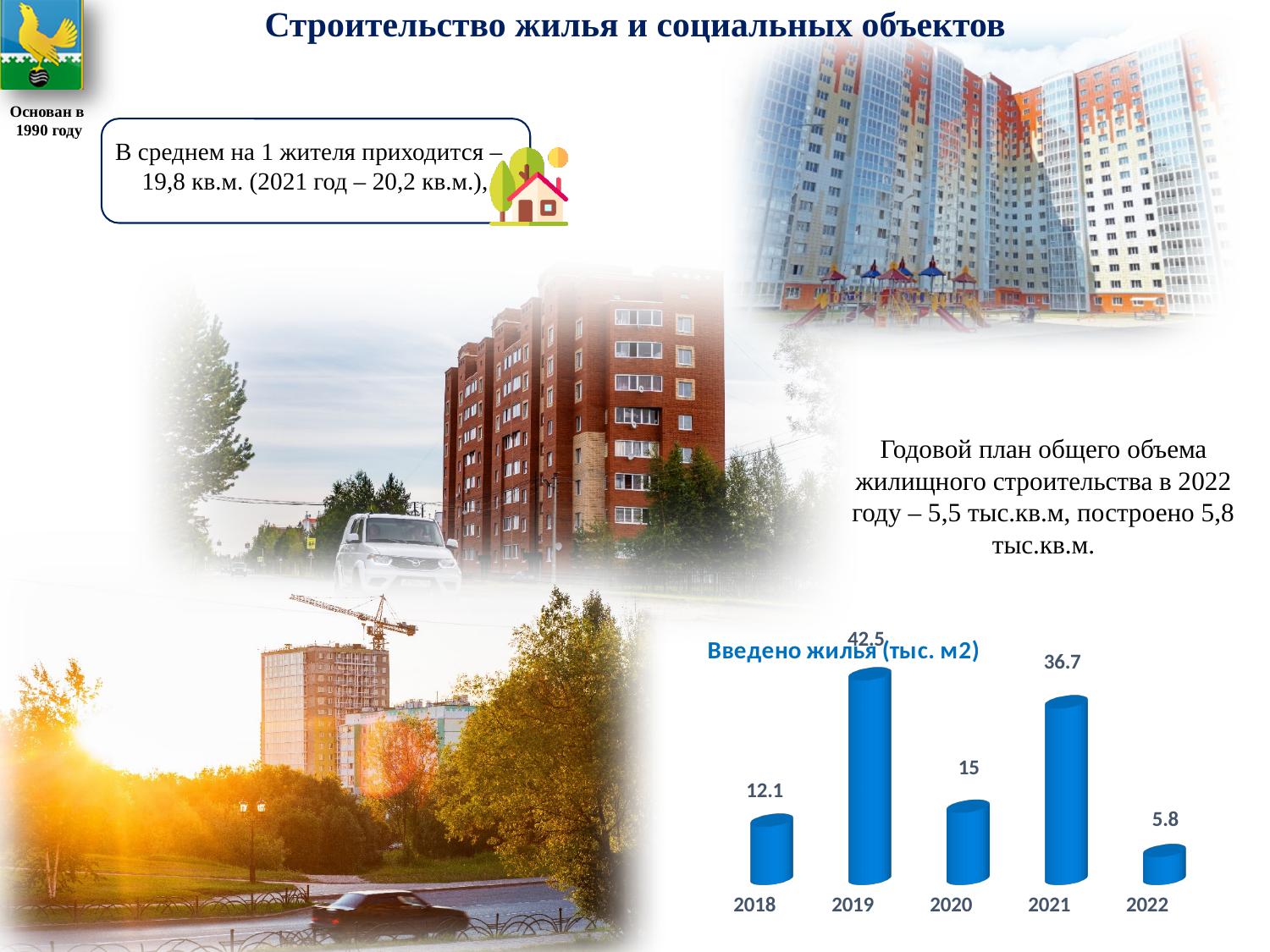
Which year has the highest value in the chart 'Введено жилья (тыс. м2)'? 2019 What is the value for 2018 in the chart 'Введено жилья (тыс. м2)'? 12.1 What is the value for 2022 in the chart 'Введено жилья (тыс. м2)'? 5.8 What is the difference between the values for 2019 and 2021 in the chart 'Введено жилья (тыс. м2)'? 5.8 What is the difference between the values for 2020 and 2018 in the chart 'Введено жилья (тыс. м2)'? 2.9 Which is larger in the chart 'Введено жилья (тыс. м2)': the value for 2020 or the value for 2018? 2020 What is the value for 2019 in the chart 'Введено жилья (тыс. м2)'? 42.5 Which year has the lowest value in the chart 'Введено жилья (тыс. м2)'? 2022 How many years are shown in the chart 'Введено жилья (тыс. м2)'? 5 What is the title of the chart on the slide? Введено жилья (тыс. м2) What is the value for 2020 in the chart 'Введено жилья (тыс. м2)'? 15 What kind of chart is 'Введено жилья (тыс. м2)'? bar chart